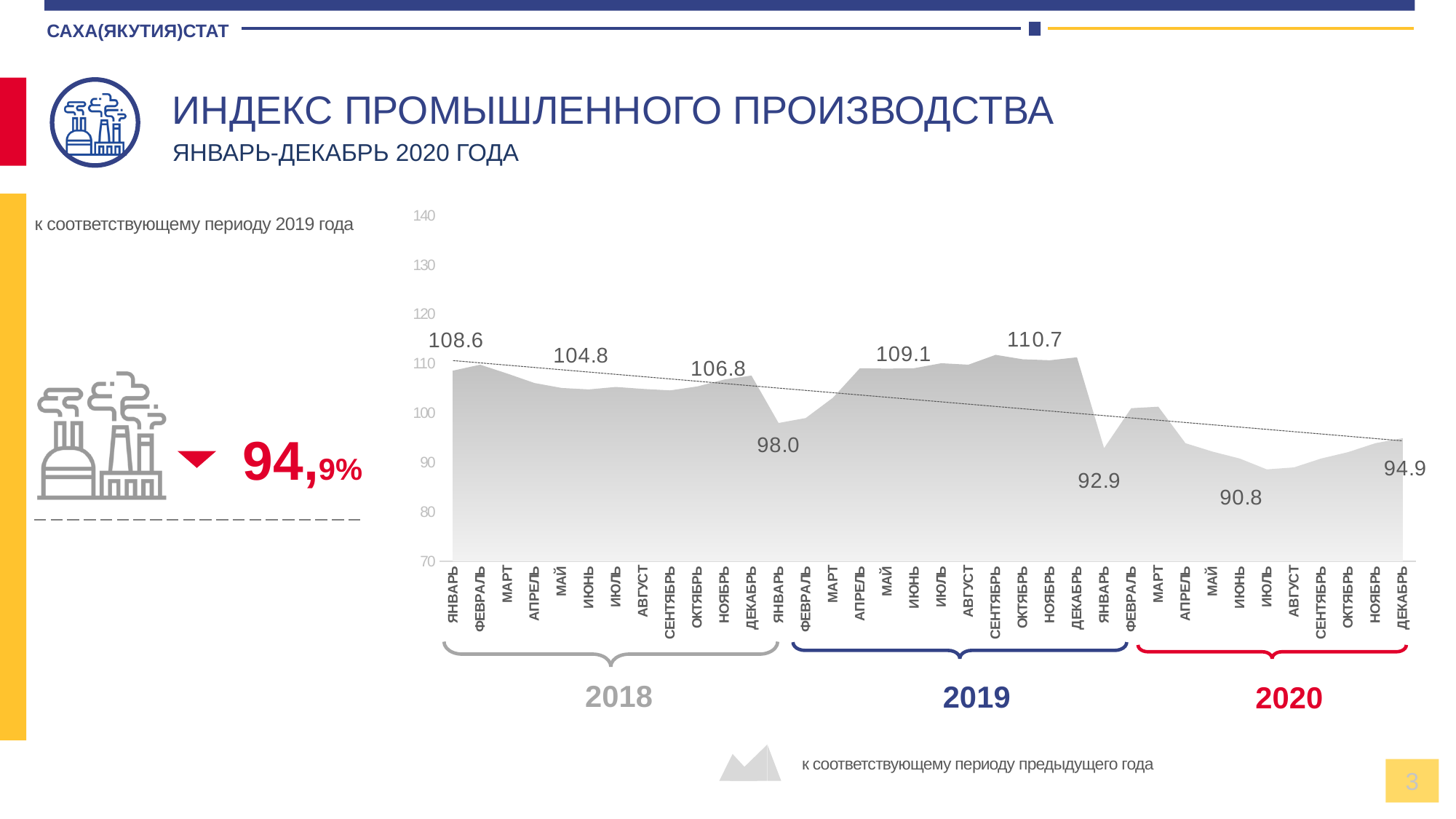
Which three years are marked by the brackets under the x axis? 2018, 2019, 2020 What is the lowest value labelled on the chart? 90.8 Is the value for December 2019 (ДЕКАБРЬ 2019) greater or less than 100? greater Which is larger, the value for January 2018 or the value for January 2019? January 2018 What is the value labelled for January 2019 (ЯНВАРЬ 2019)? 98.0 What is the value labelled for January 2020 (ЯНВАРЬ 2020)? 92.9 Does the dashed trend line across the chart rise or fall from left to right? fall What is the difference between the January 2018 value (108.6) and the December 2020 value (94.9)? 13.7 What is the value labelled for December 2020 (ДЕКАБРЬ 2020)? 94.9 What kind of chart is shown on the slide? area chart What is the industrial production index value for January 2018 (ЯНВАРЬ 2018)? 108.6 What is the highest value labelled on the chart? 110.7